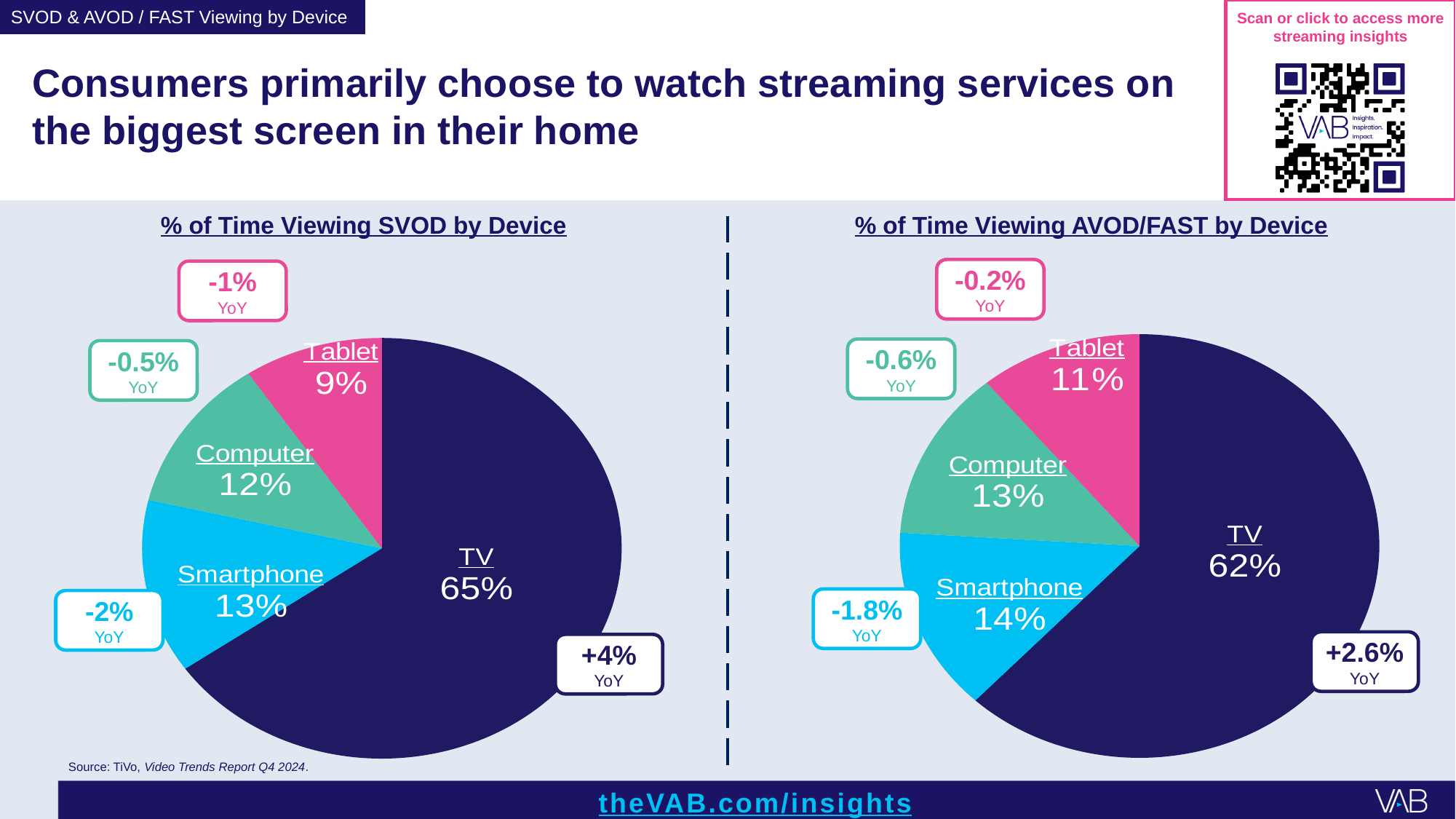
How many device categories are shown in the '% of Time Viewing AVOD/FAST by Device' chart? 4 In the '% of Time Viewing SVOD by Device' chart, which device has the smallest share? Tablet Which is larger in the '% of Time Viewing SVOD by Device' chart: the Computer share or the Smartphone share? Smartphone In the '% of Time Viewing SVOD by Device' chart, what share of time is spent viewing on TV? 65% In the '% of Time Viewing AVOD/FAST by Device' chart, what is the difference between the TV and Computer shares? 49% In the '% of Time Viewing AVOD/FAST by Device' chart, which device has the largest share? TV In the '% of Time Viewing AVOD/FAST by Device' chart, what is the YoY change shown for Smartphone? -1.8% In the '% of Time Viewing SVOD by Device' chart, what is the difference between the Smartphone and Tablet shares? 4% What type of chart is the '% of Time Viewing SVOD by Device' chart? Pie chart What colour is the Tablet slice in the '% of Time Viewing SVOD by Device' chart? Pink In the '% of Time Viewing AVOD/FAST by Device' chart, what share of time is spent viewing on Smartphone? 14% In the '% of Time Viewing SVOD by Device' chart, what is the YoY change shown for TV? +4%